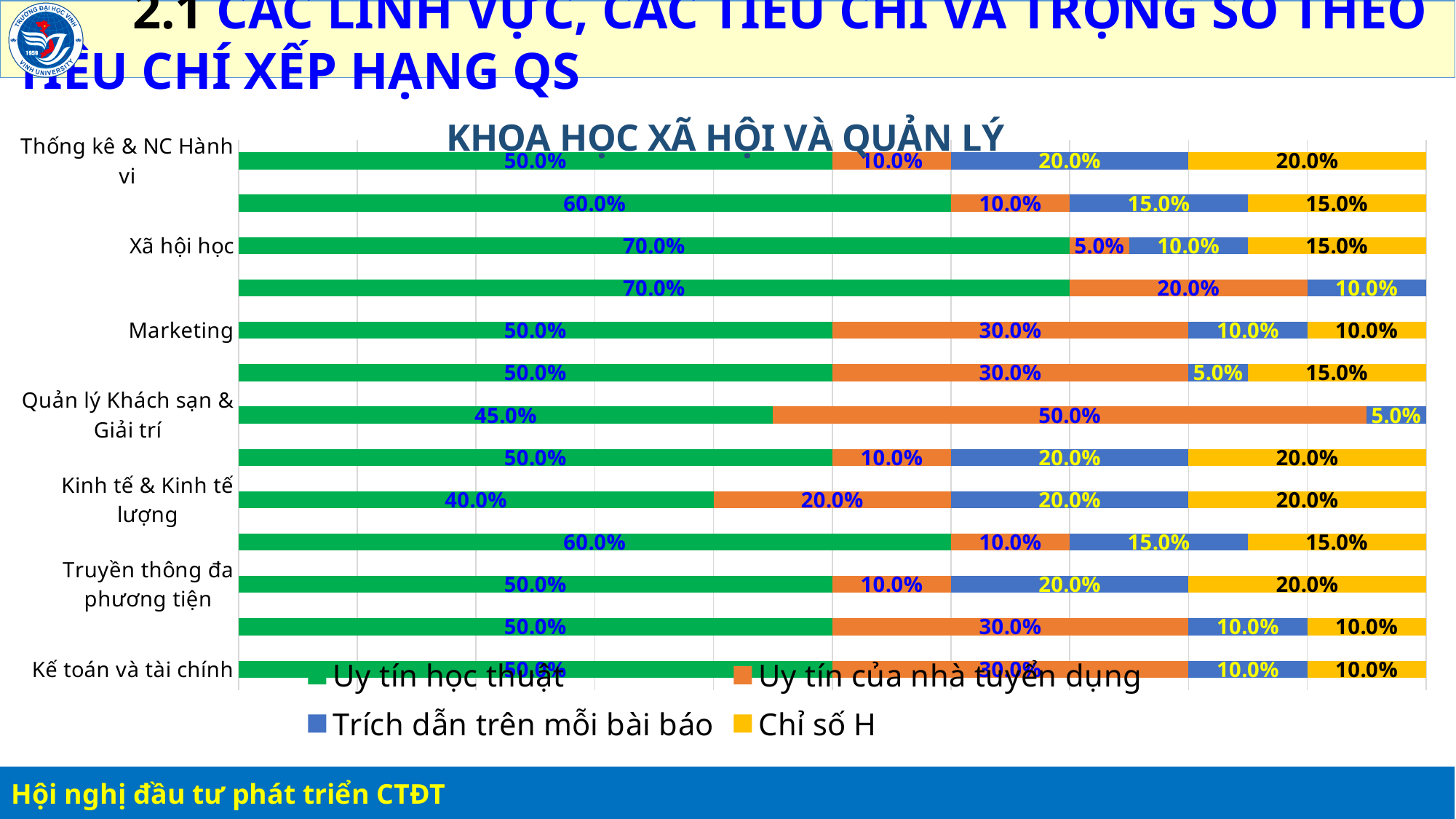
How many series does the legend list? 4 What is the value of Chỉ số H for Marketing? 10.0% What is the difference between the Uy tín học thuật value for Xã hội học and for Kinh tế & Kinh tế lượng? 30.0% What is the value of Uy tín học thuật for Kinh tế & Kinh tế lượng? 40.0% What kind of chart is shown on the slide? Stacked bar chart Which has the larger Uy tín của nhà tuyển dụng value, Marketing or Xã hội học? Marketing Which labelled category has the lowest Uy tín học thuật value? Kinh tế & Kinh tế lượng What is the value of Uy tín của nhà tuyển dụng for Quản lý Khách sạn & Giải trí? 50.0% What colour represents the Chỉ số H series? Yellow What is the title of the chart? KHOA HỌC XÃ HỘI VÀ QUẢN LÝ What is the value of Trích dẫn trên mỗi bài báo for Thống kê & NC Hành vi? 20.0% What is the value of Uy tín học thuật for Xã hội học? 70.0%